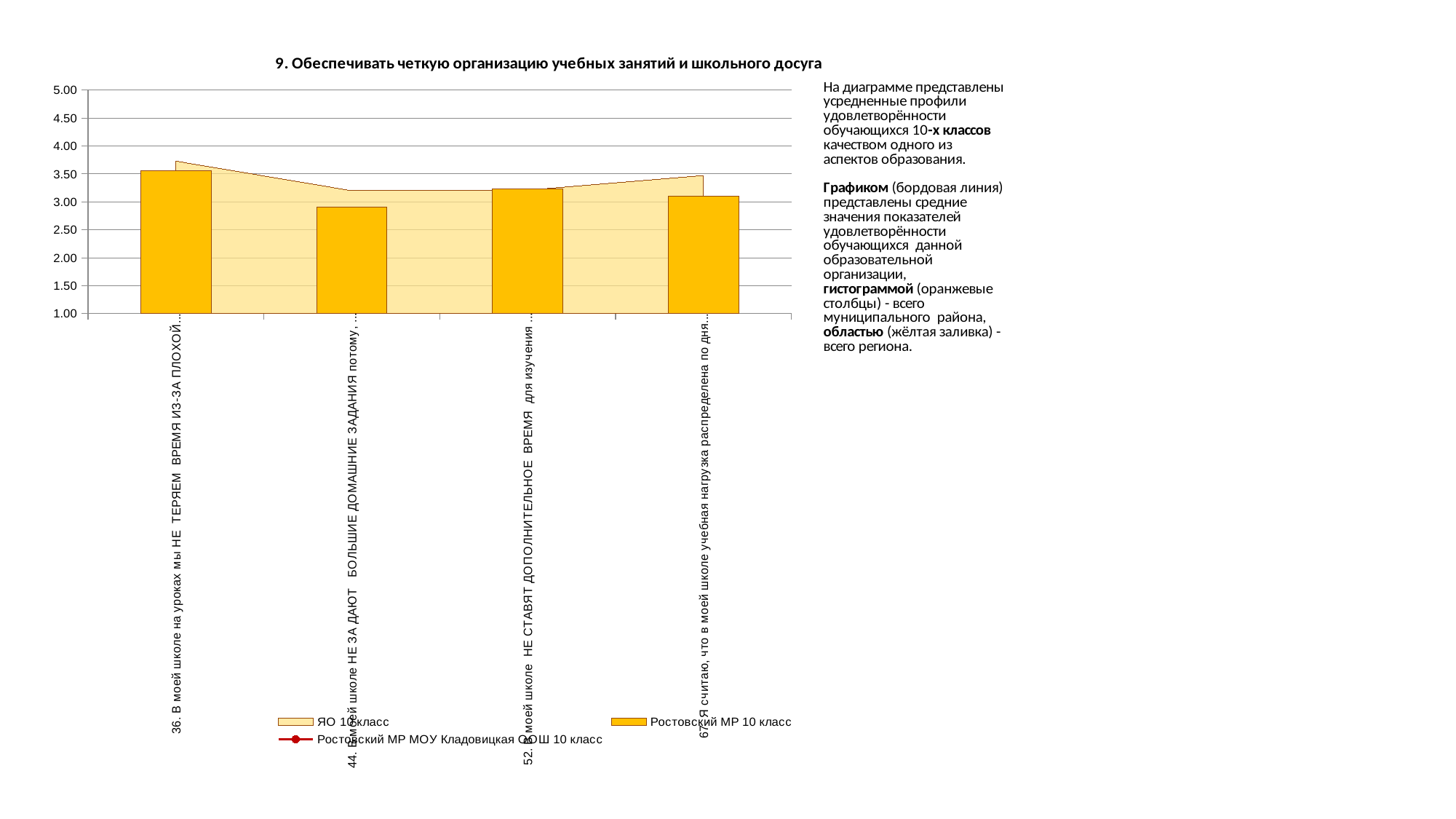
What colour represents the series Ростовский МР 10 класс in the legend? Orange Which category has the highest orange bar (Ростовский МР 10 класс)? 36 (В моей школе на уроках мы НЕ ТЕРЯЕМ ВРЕМЯ ИЗ-ЗА ПЛОХОЙ...) Is the ЯО 10 класс value for statement 36 greater or less than 3.50? greater Which is larger for Ростовский МР 10 класс: the value for statement 36 or for statement 44? Statement 36 What kind of chart is shown on the slide? A combination of a bar chart and an area chart For statement 44, which is larger: the ЯО 10 класс value or the Ростовский МР 10 класс value? ЯО 10 класс Which category has the lowest orange bar (Ростовский МР 10 класс)? 44 (В моей школе НЕ ЗА ДАЮТ БОЛЬШИЕ ДОМАШНИЕ ЗАДАНИЯ потому...) Do the Ростовский МР 10 класс bars rise or fall from statement 36 to statement 44? fall How many series does the legend list? 3 Is the Ростовский МР 10 класс value for statement 44 greater or less than 3.00? less Is the Ростовский МР 10 класс value for statement 36 greater or less than 3.00? greater How many categories (survey statements) are plotted along the x axis? 4